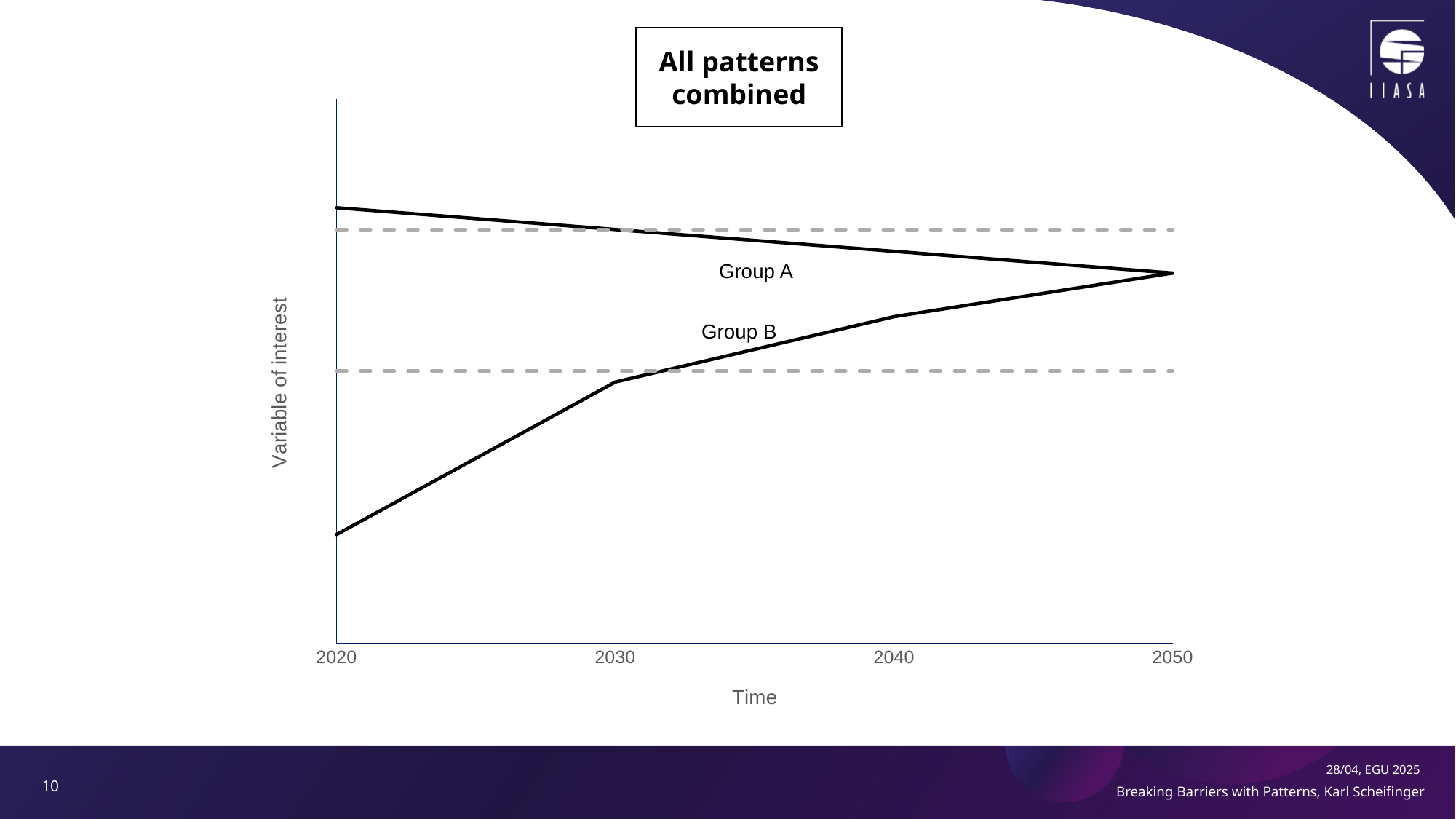
What is the label of the x axis? Time Which group has the lowest value shown anywhere on the chart? Group B How many year labels are shown on the x axis? 4 Does the Group A line rise or fall from 2020 to 2050? fall In 2030, which group has the higher value, Group A or Group B? Group A In 2020, which group has the higher value, Group A or Group B? Group A What is the title of the chart? All patterns combined What kind of chart is shown on the slide? line chart How many groups (lines) are plotted in the chart? 2 Does the Group B line rise or fall from 2020 to 2050? rise In which year do the Group A and Group B lines meet? 2050